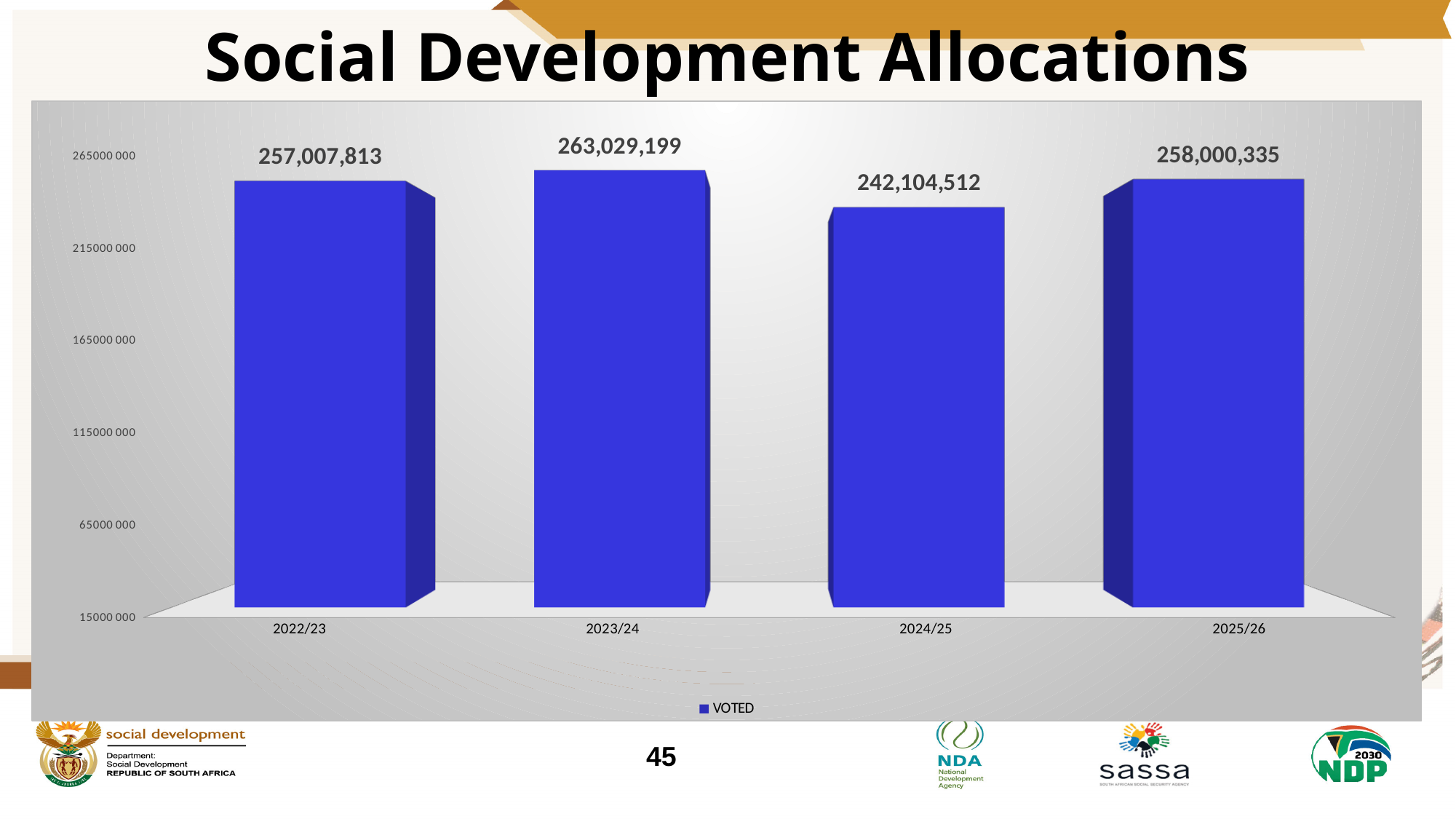
What is the difference between the 2025/26 and 2024/25 allocations? 15,895,823 What kind of chart is shown on the slide? Bar chart What is the VOTED allocation for 2022/23? 257,007,813 Is the value for 2024/25 greater or less than 215000 000? greater How many years are shown on the x axis? 4 Which year has the highest allocation? 2023/24 What is the VOTED allocation for 2024/25? 242,104,512 Which year has the lowest allocation? 2024/25 What is the VOTED allocation for 2025/26? 258,000,335 What series name does the legend show? VOTED What is the difference between the 2023/24 and 2022/23 allocations? 6,021,386 Which is larger, the allocation for 2022/23 or for 2025/26? 2025/26